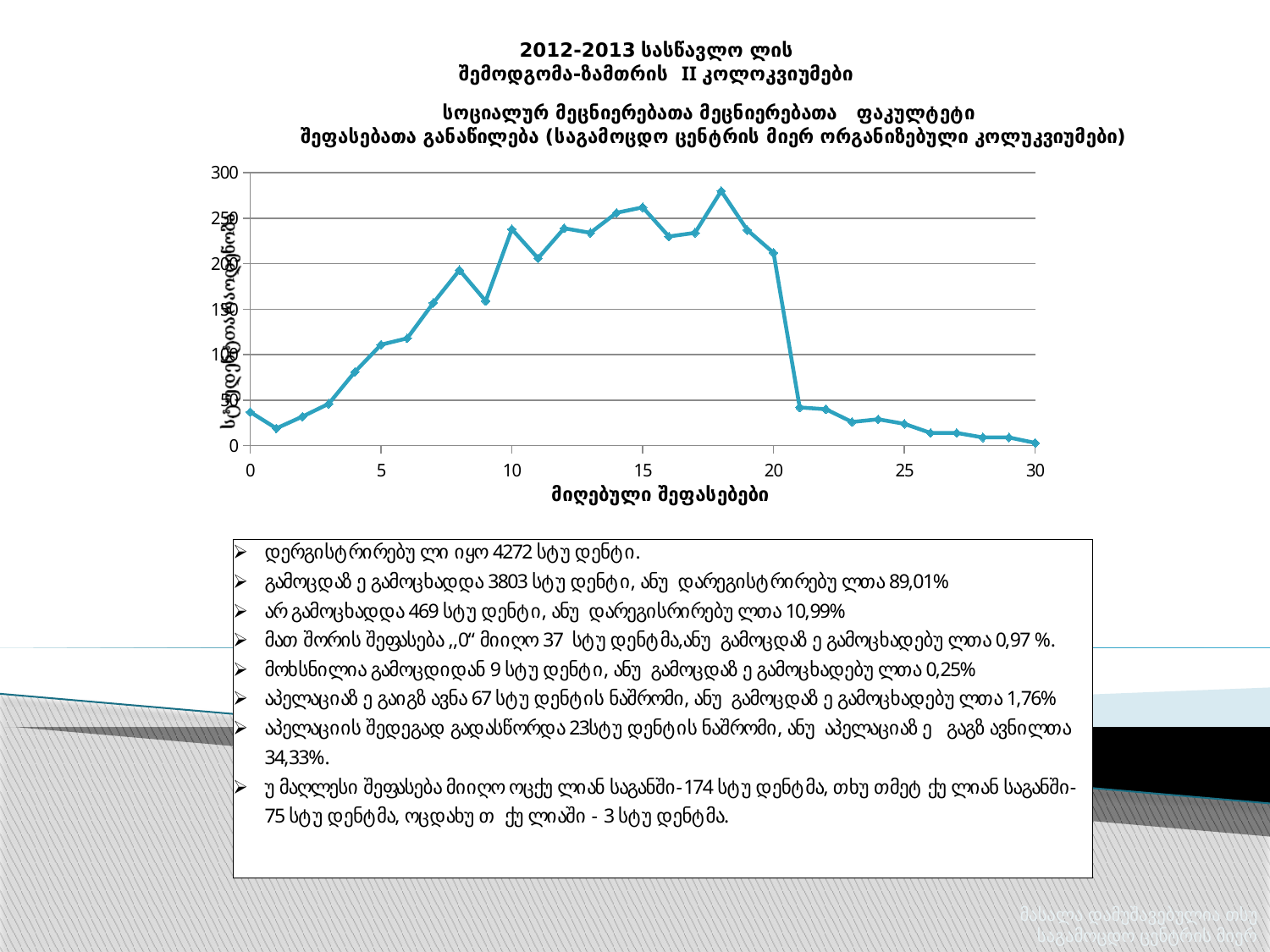
At which x-axis value (received score) does the line reach its highest point? 18 At which x-axis value (received score) does the line reach its lowest point? 30 What kind of chart is shown on the slide? line chart What is the title of the x axis? მიღებული შეფასებები Is the value at x = 8 greater or less than 150? greater Is the value at x = 4 greater or less than 100? less Is the value at x = 12 greater or less than 200? greater Which is larger: the value at x = 10 or the value at x = 25? x = 10 Between x = 20 and x = 21, does the line rise or fall? fall